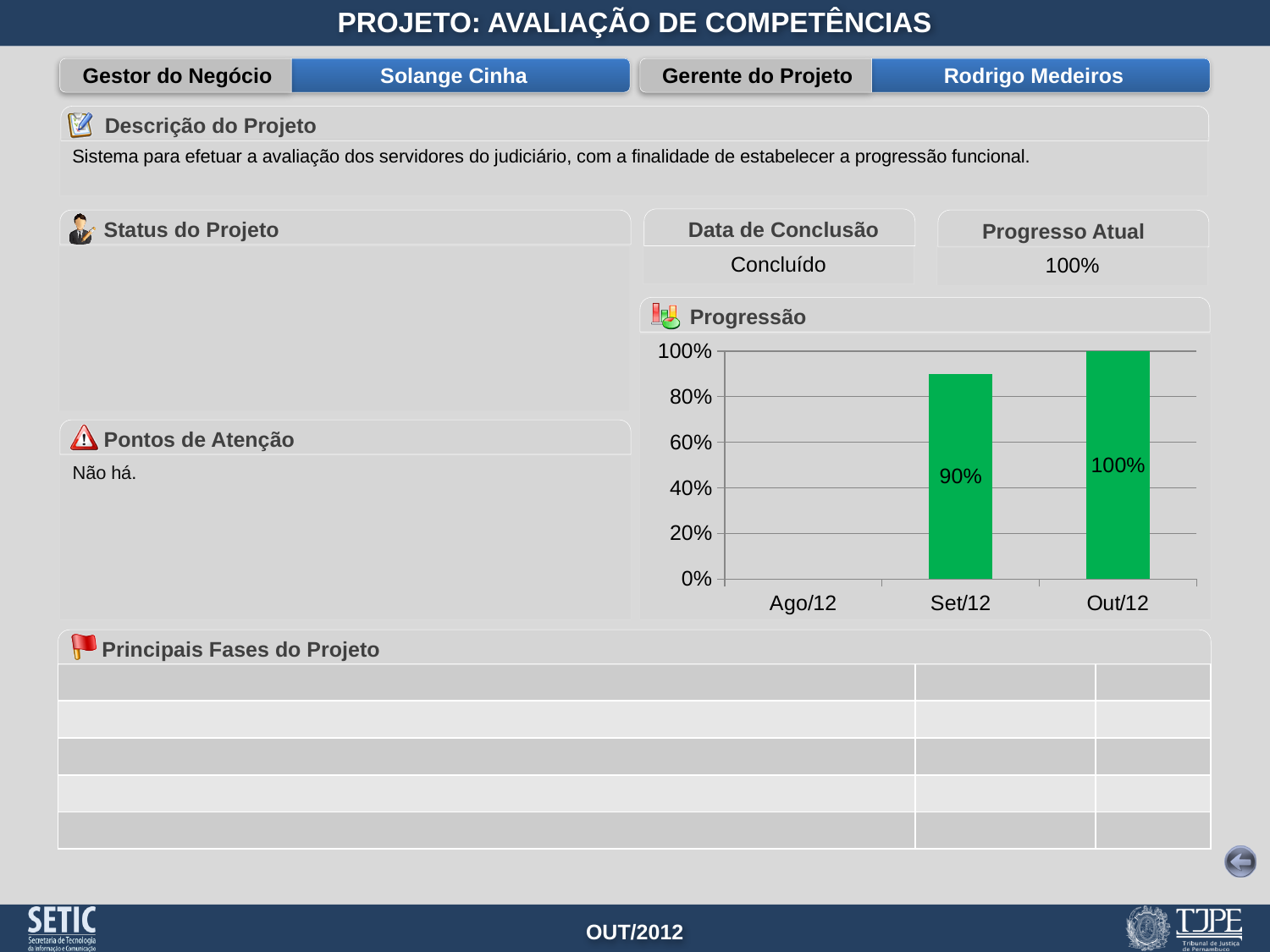
In the Progressão chart, which is larger, the value for Set/12 or the value for Out/12? Out/12 Which month has the highest value in the Progressão chart? Out/12 How many months are shown on the x axis of the Progressão chart? 3 What is the highest value shown on the y axis of the Progressão chart? 100% What colour are the bars in the Progressão chart? green What type of chart is shown under "Progressão"? bar chart What is the difference between the values for Out/12 and Set/12 in the Progressão chart? 10% What is the title of the chart on the slide? Progressão What is the value for Out/12 in the Progressão chart? 100% Is the value for Set/12 in the Progressão chart greater or less than 80%? greater Do the values in the Progressão chart rise or fall from Set/12 to Out/12? rise What is the value for Set/12 in the Progressão chart? 90%